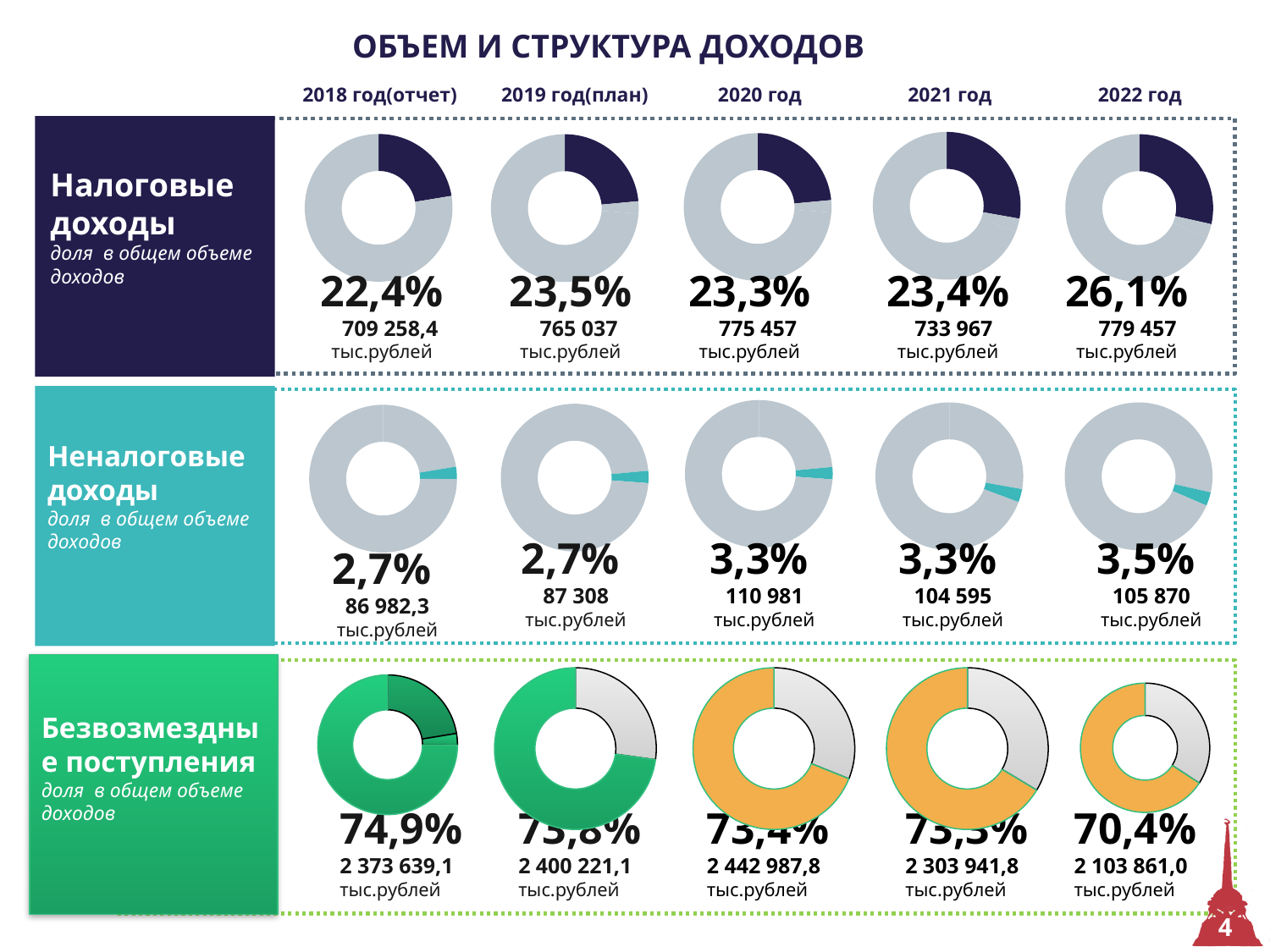
In the Неналоговые доходы row, which year has the highest share? 2022 год How many years (columns) are shown across the top of the slide? 5 In the Неналоговые доходы row, what amount in тыс.рублей is shown for 2019 год(план)? 87 308 тыс.рублей In the Налоговые доходы row, which year has the highest share? 2022 год In the Налоговые доходы row, what is the difference in share between 2022 год and 2018 год(отчет)? 3,7% In the Безвозмездные поступления row, what share is shown for 2018 год(отчет)? 74,9% In the Налоговые доходы row, what share is shown for 2022 год? 26,1% In the Неналоговые доходы row, what share is shown for 2020 год? 3,3% What kind of chart is used to show each share on this slide? Donut (pie) chart In the Безвозмездные поступления row, what amount in тыс.рублей is shown for 2022 год? 2 103 861,0 тыс.рублей In the Налоговые доходы row, what amount in тыс.рублей is shown for 2018 год(отчет)? 709 258,4 тыс.рублей In the Безвозмездные поступления row, which is larger: the amount for 2020 год or for 2021 год? 2020 год